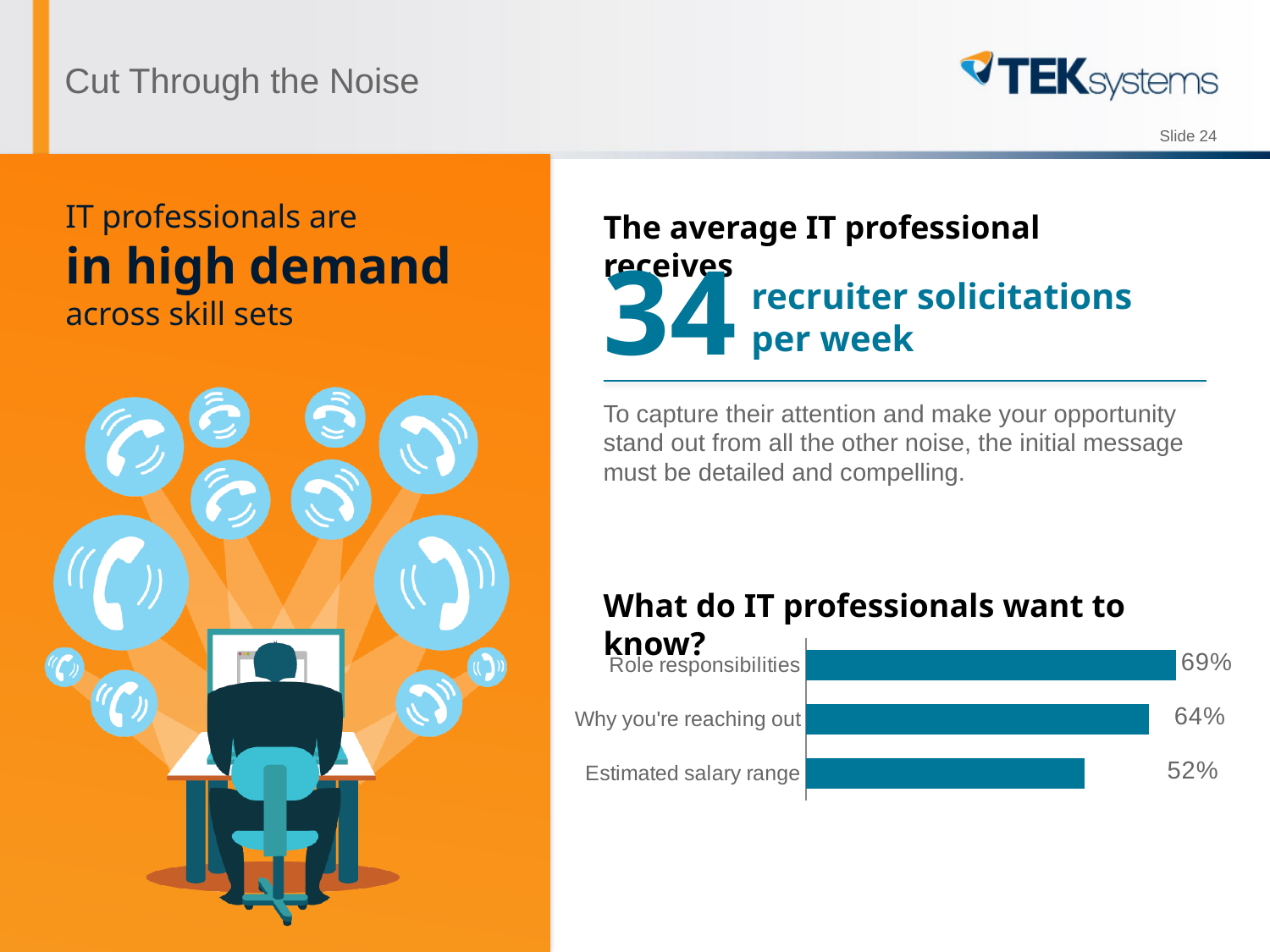
What is the difference between the values for 'Role responsibilities' and 'Why you're reaching out'? 5% What is the value for 'Why you're reaching out'? 64% What colour are the bars in the chart? Teal blue What is the title of the chart? What do IT professionals want to know? What is the difference between the values for 'Role responsibilities' and 'Estimated salary range'? 17% Which category has the highest value in the chart? Role responsibilities Which category has the lowest value in the chart? Estimated salary range Which is larger: the value for 'Why you're reaching out' or 'Estimated salary range'? Why you're reaching out What kind of chart is shown on the slide? Bar chart How many categories are shown in the chart? 3 What is the value for 'Estimated salary range'? 52% What percentage of IT professionals want to know the role responsibilities? 69%